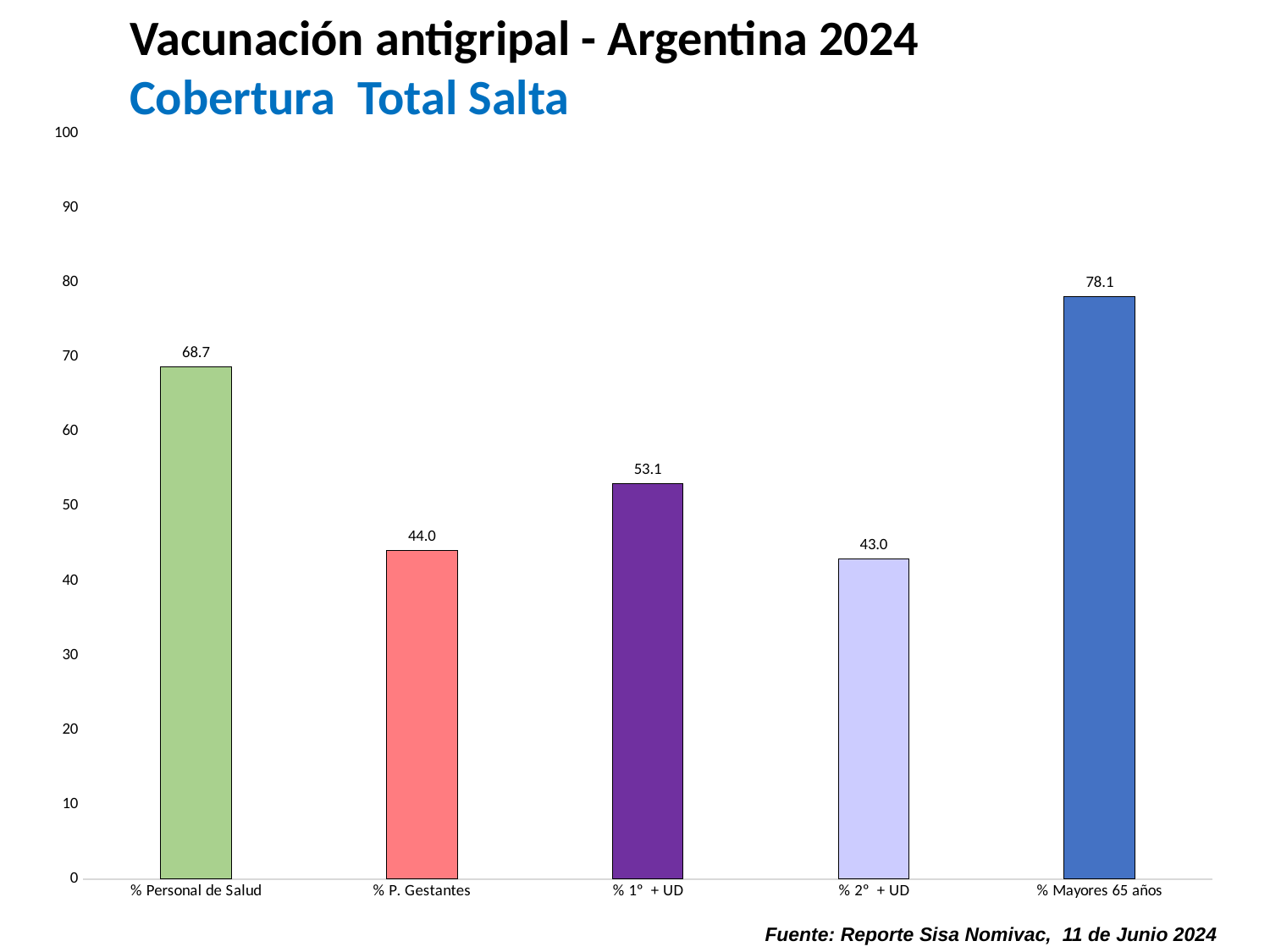
What is the value for % Mayores 65 años? 78.1 Which is larger, the value for % 1° + UD or the value for % 2° + UD? % 1° + UD What is the value for % P. Gestantes? 44.0 What is the difference between the values for % Mayores 65 años and % Personal de Salud? 9.4 Which category has the highest value? % Mayores 65 años What is the value for % Personal de Salud? 68.7 Is the value for % Personal de Salud greater or less than 60? greater How many categories are shown on the x axis? 5 What is the value for % 1° + UD? 53.1 Which category has the lowest value? % 2° + UD What is the subtitle of the chart shown in blue? Cobertura Total Salta What kind of chart is shown on the slide? bar chart